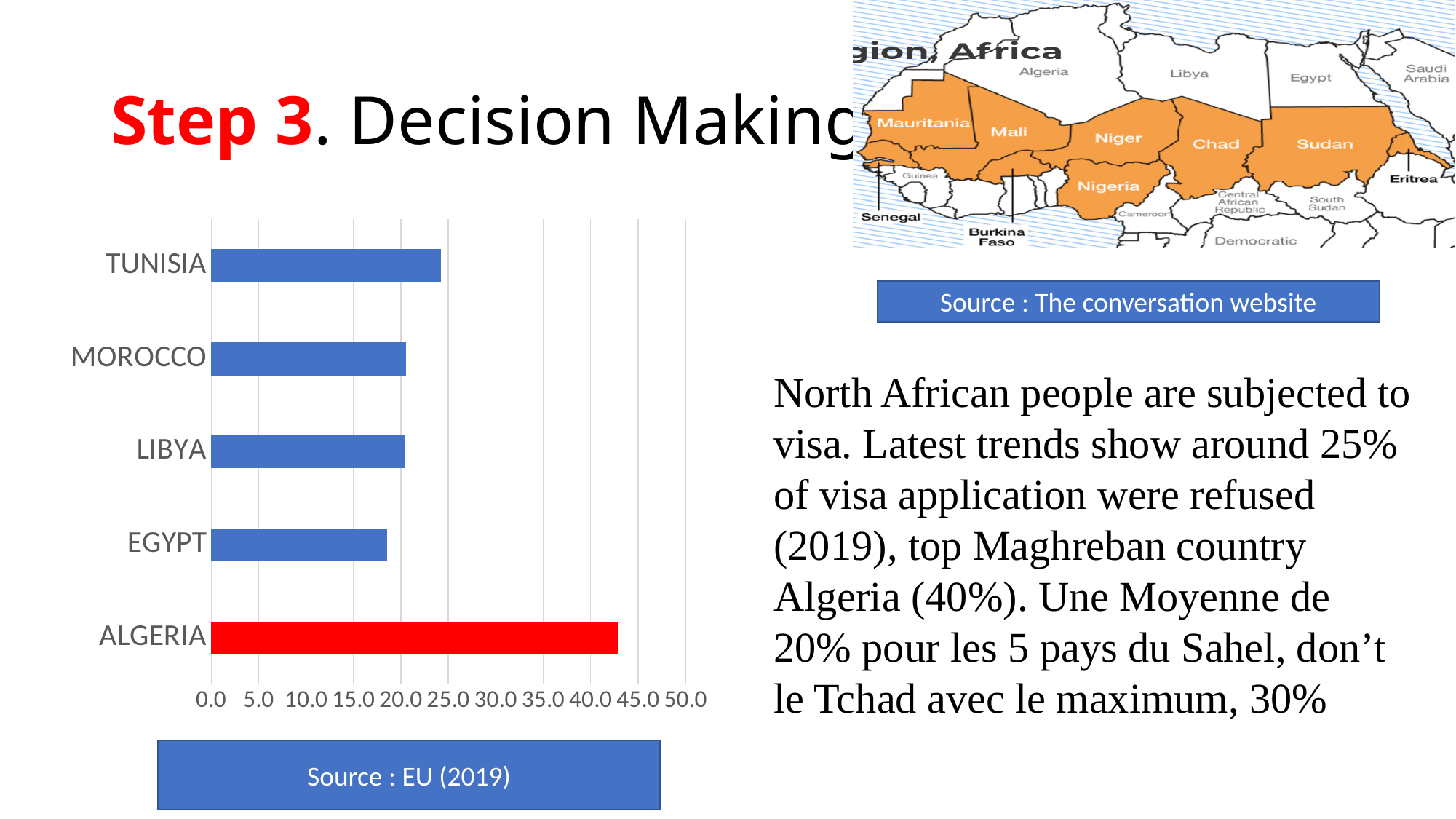
Which country has the lowest value in the bar chart? EGYPT Which country's bar is coloured red in the bar chart? ALGERIA Is the value for ALGERIA greater or less than 40.0? greater Which country has the highest value in the bar chart? ALGERIA Is the value for TUNISIA greater or less than 20.0? greater Is the value for TUNISIA greater or less than 25.0? less What kind of chart is shown on the slide? bar chart What source is given below the bar chart? Source : EU (2019) How many countries are plotted in the bar chart? 5 Which has the larger value, ALGERIA or TUNISIA? ALGERIA Which has the larger value, TUNISIA or EGYPT? TUNISIA